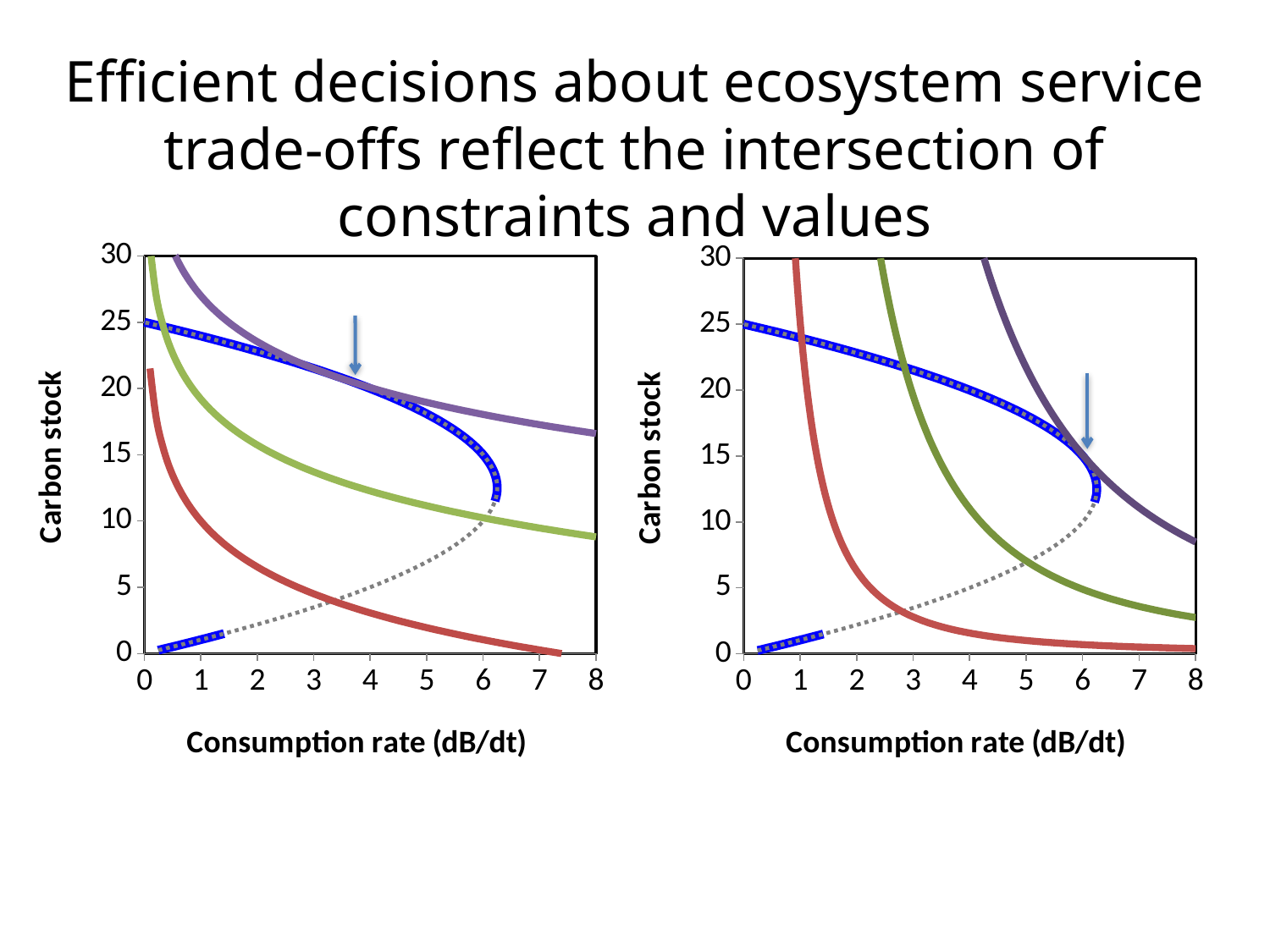
In the left chart, does the red line rise or fall as the consumption rate increases? fall What is the x-axis label of the left chart? Consumption rate (dB/dt) In the left chart, is the value of the green line at a consumption rate of 8 greater or less than 10? less What is the y-axis label of the right chart? Carbon stock In the right chart, is the value of the green line at a consumption rate of 8 greater or less than 5? less In the left chart, is the value of the red line at a consumption rate of 4 greater or less than 5? less In the right chart, does the purple line rise or fall as the consumption rate increases? fall What kind of chart is shown on the left side of the slide? line chart What kind of chart is shown on the right side of the slide? line chart